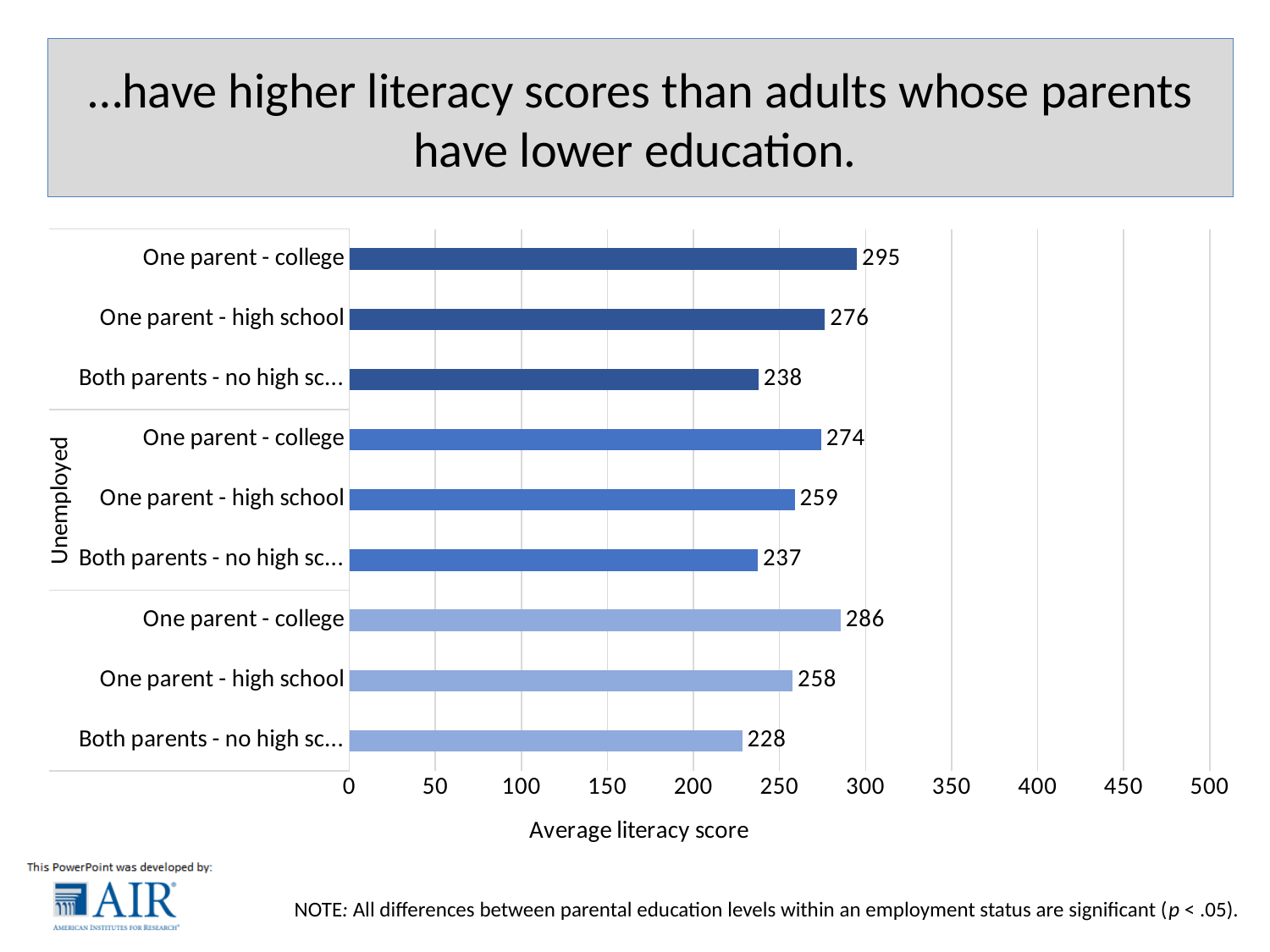
What is the average literacy score for 'One parent - high school' in the Unemployed group? 259 What is the average literacy score for the topmost bar ('One parent - college' in the top group)? 295 In the bottom group, which is larger: the 'One parent - college' score or the 'One parent - high school' score? One parent - college What kind of chart is shown on the slide? Bar chart How many bars are plotted on the chart? 9 What is the average literacy score for 'One parent - college' in the Unemployed group? 274 Which bar has the lowest average literacy score on the chart? Both parents - no high sc... (bottom group), 228 Which bar has the highest average literacy score on the chart? One parent - college (top group), 295 What is the label of the horizontal axis? Average literacy score Within the Unemployed group, what is the difference between the 'One parent - college' score and the 'Both parents - no high sc...' score? 37 What is the maximum value shown on the horizontal axis? 500 What is the average literacy score for the bottommost bar ('Both parents - no high sc...' in the bottom group)? 228